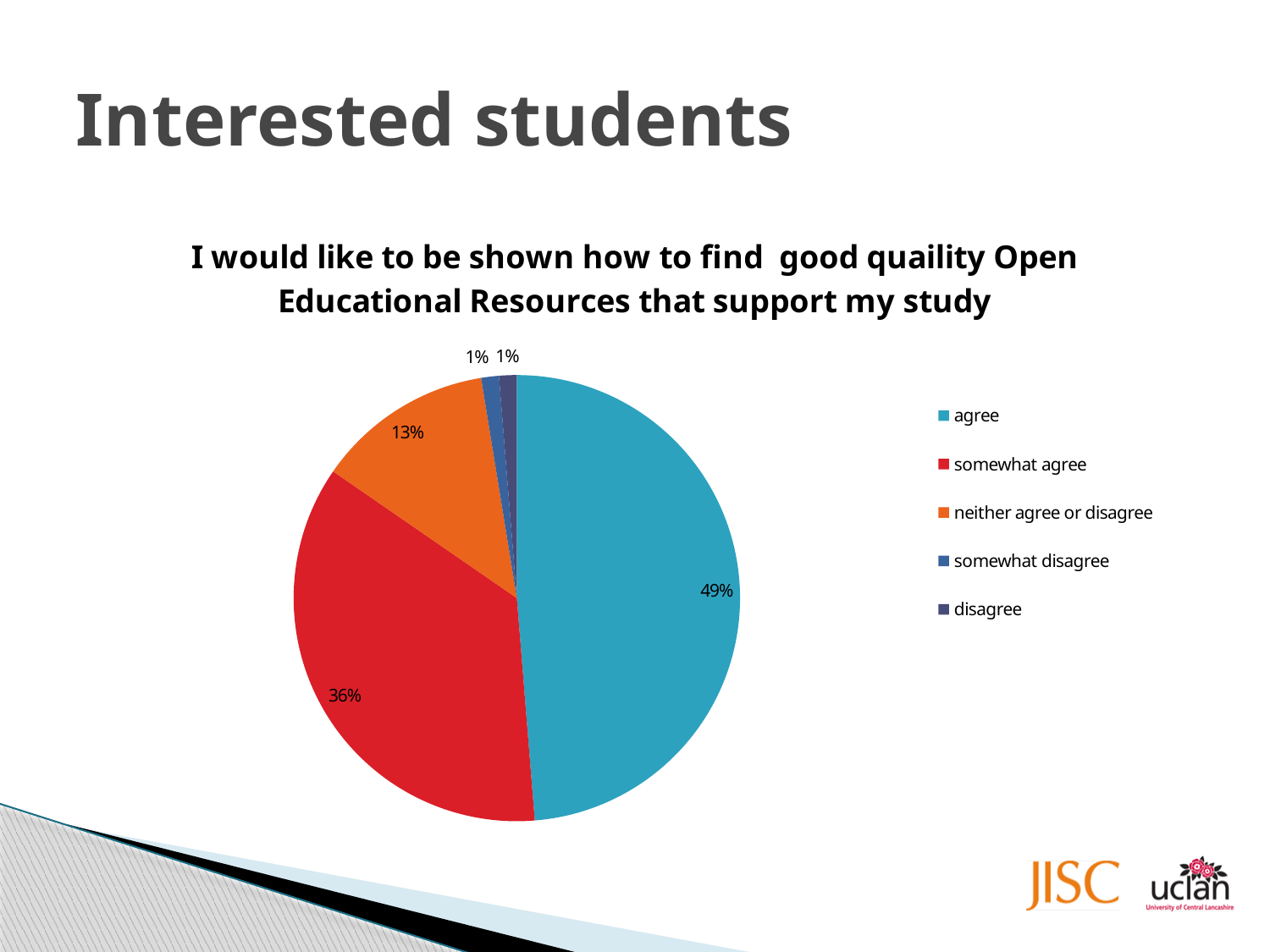
How many response categories does the legend list? 5 What percentage of respondents chose "agree"? 49% Which response category has the largest share of the pie? agree What is the title of the chart? I would like to be shown how to find good quaility Open Educational Resources that support my study Which is larger, the share for "somewhat agree" or the share for "neither agree or disagree"? somewhat agree What percentage of respondents chose "somewhat disagree"? 1% What percentage of respondents chose "neither agree or disagree"? 13% What kind of chart is shown on the slide? pie chart What percentage of respondents chose "somewhat agree"? 36% What is the difference in percentage points between "agree" and "somewhat agree"? 13 What is the combined share of "agree" and "somewhat agree"? 85% Which colour represents "neither agree or disagree" in the chart? orange